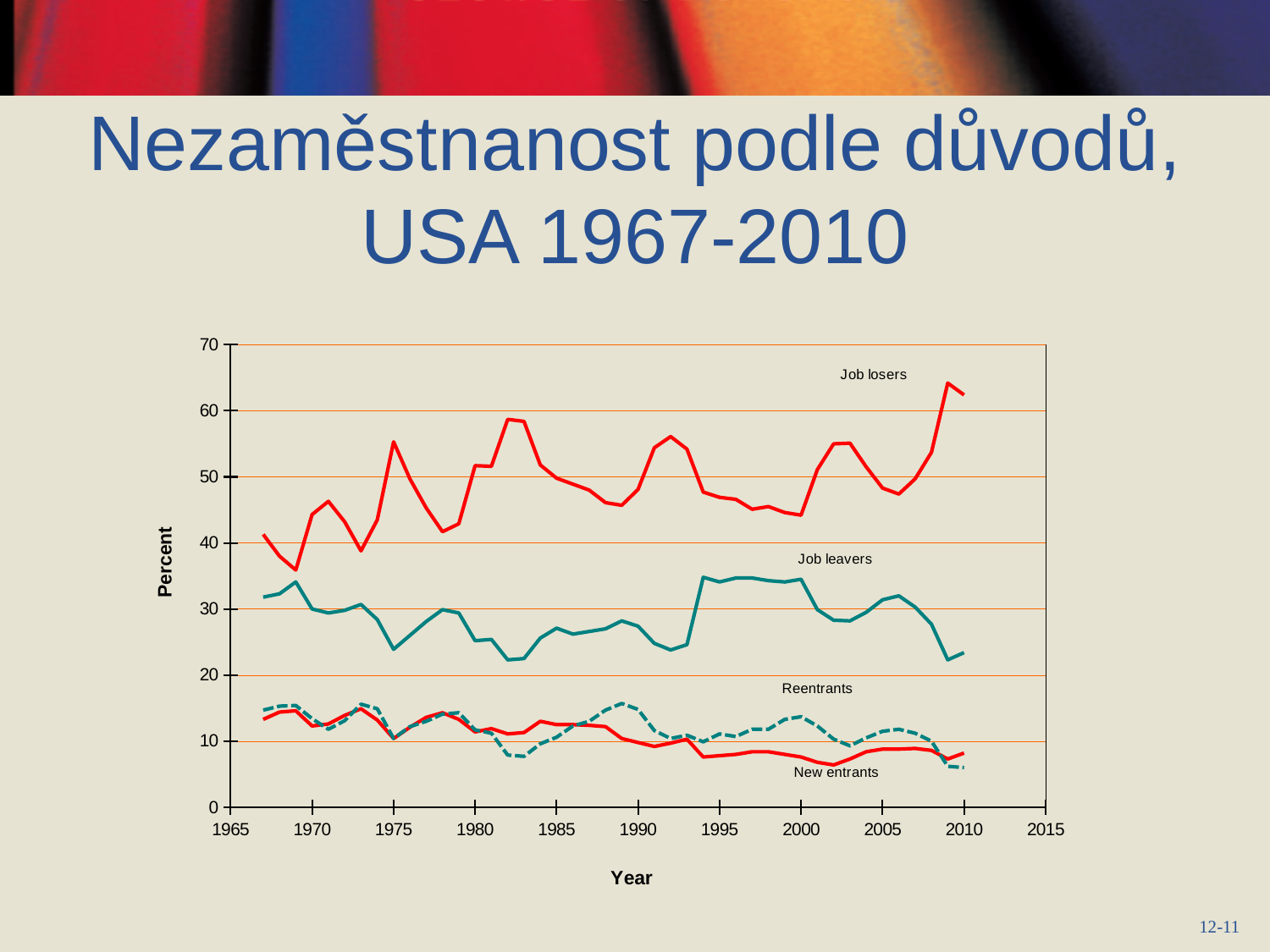
Is the value for Job losers in 1969 greater or less than 40? less Is the value for Job leavers in 2009 greater or less than 30? less In 2010, which is larger: Job losers or Job leavers? Job losers How many series (labelled lines) are plotted on the chart? 4 Which series has the highest values throughout the chart? Job losers What is the label of the vertical axis? Percent Is the value for Job leavers in 1995 greater or less than 30? greater What is the label of the horizontal axis? Year Do the values for Job losers rise or fall between 2006 and 2010? rise What kind of chart is shown on the slide? line chart